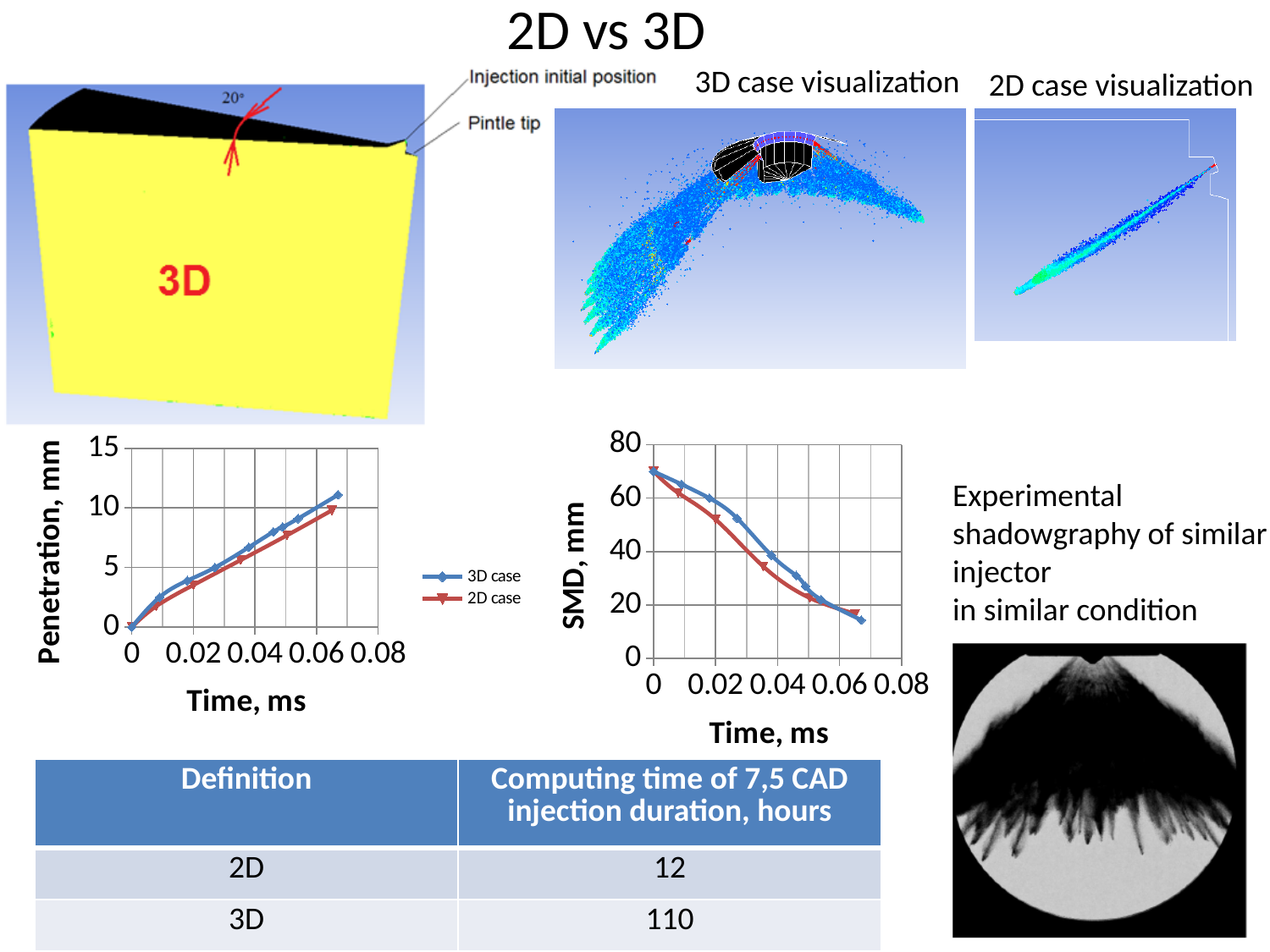
In the SMD, mm chart, do the values of the 2D case rise or fall as time increases? fall In the SMD, mm chart, is the starting value of the 3D case at time 0 greater or less than 60? greater In the SMD, mm chart, is the value of the 2D case at time 0.04 greater or less than 40? less What kind of chart is the Penetration, mm vs Time, ms chart? line chart What kind of chart is the SMD, mm vs Time, ms chart? line chart In the Penetration, mm chart, is the value of the 3D case at time 0.02 greater or less than 5? less What is the x-axis title of the SMD, mm chart? Time, ms In the Penetration, mm chart, what is the penetration value of both series at time 0? 0 How many series does the legend list for the Penetration and SMD charts? 2 In the Penetration, mm chart, which series has the higher value at time 0.04, the 3D case or the 2D case? 3D case In the Penetration, mm chart, do the values of the 3D case rise or fall as time increases? rise